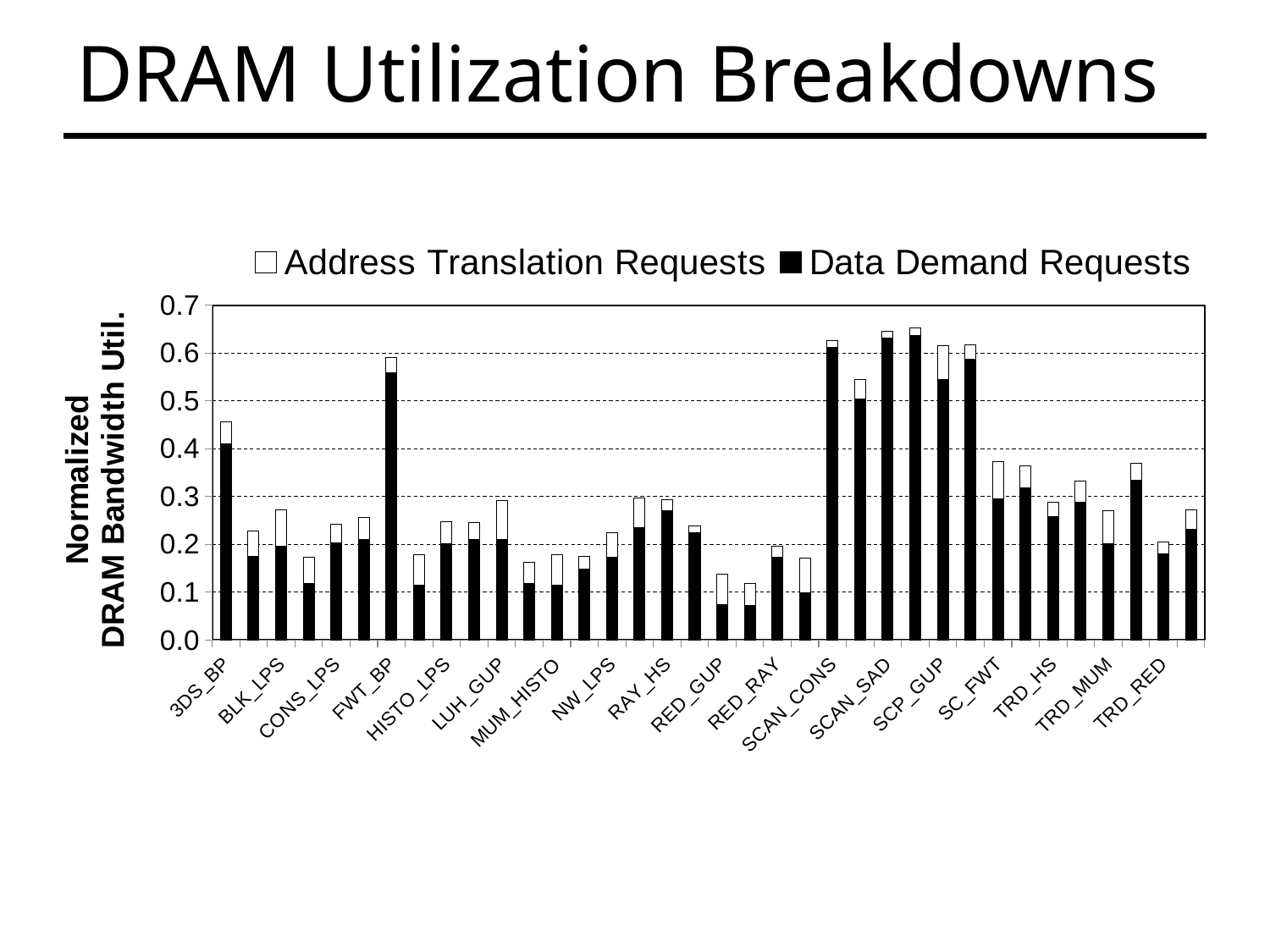
Is the total value for MUM_HISTO greater or less than 0.3? less Is the total value for 3DS_BP greater or less than 0.4? greater What are the two series named in the legend? Address Translation Requests and Data Demand Requests Which has the larger total value, FWT_BP or 3DS_BP? FWT_BP Is the total value for FWT_BP greater or less than 0.5? greater What is the y-axis title of the chart? Normalized DRAM Bandwidth Util. How many category labels are printed along the x axis? 18 Which has the larger total value, SCAN_CONS or TRD_HS? SCAN_CONS What kind of chart is shown on the slide? bar chart How many series does the legend list? 2